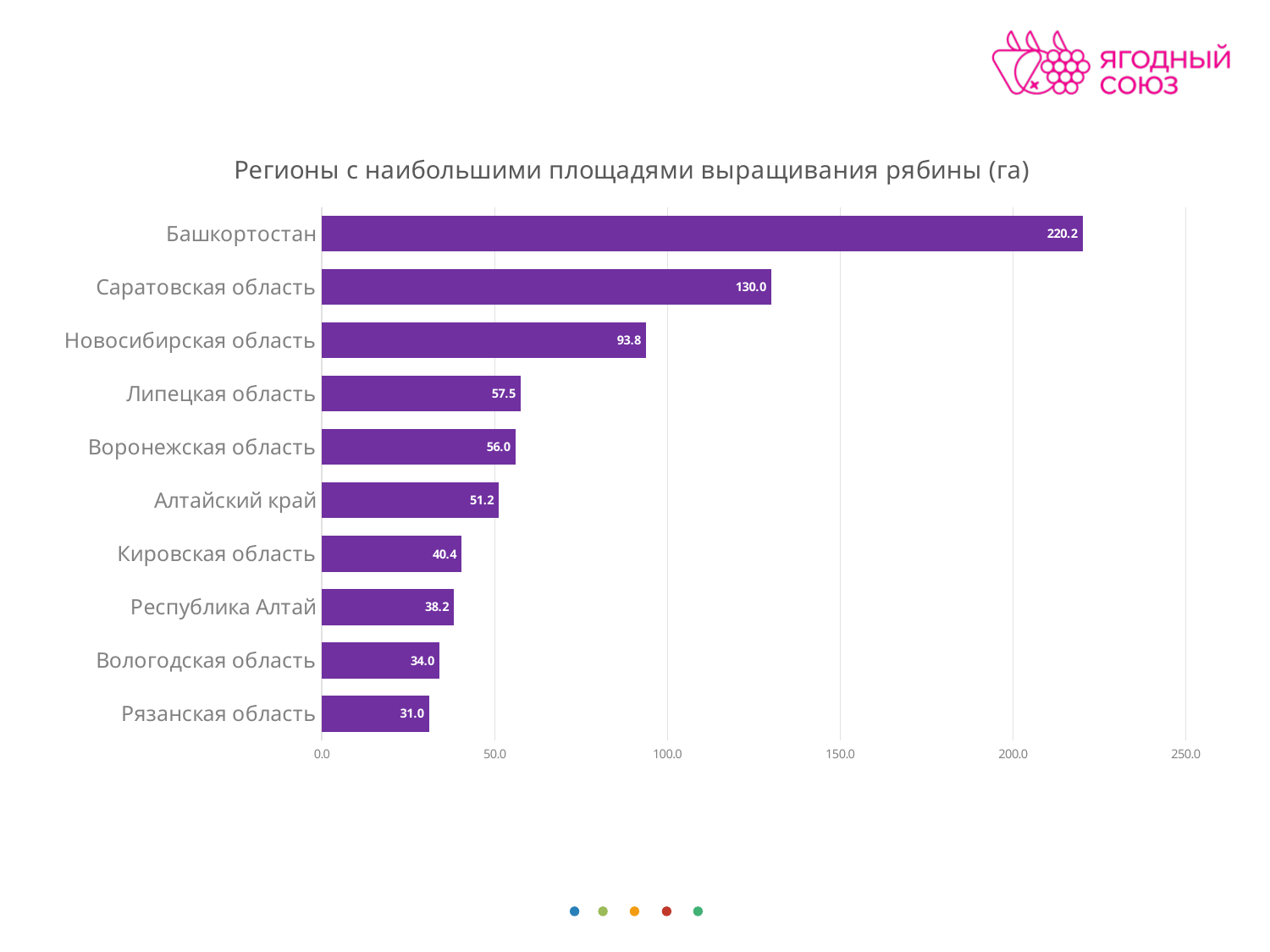
What is the difference between the values for Башкортостан and Саратовская область? 90.2 What is the value for Новосибирская область? 93.8 Which region has the lowest value? Рязанская область What is the difference between the values for Липецкая область and Воронежская область? 1.5 Which region has the highest value? Башкортостан How many regions are shown in the chart? 10 Which is larger, the value for Кировская область or the value for Республика Алтай? Кировская область What is the title of the chart? Регионы с наибольшими площадями выращивания рябины (га) What is the value for Вологодская область? 34.0 Is the value for Саратовская область greater or less than 100.0? greater What kind of chart is shown on the slide? bar chart What is the value for Башкортостан? 220.2